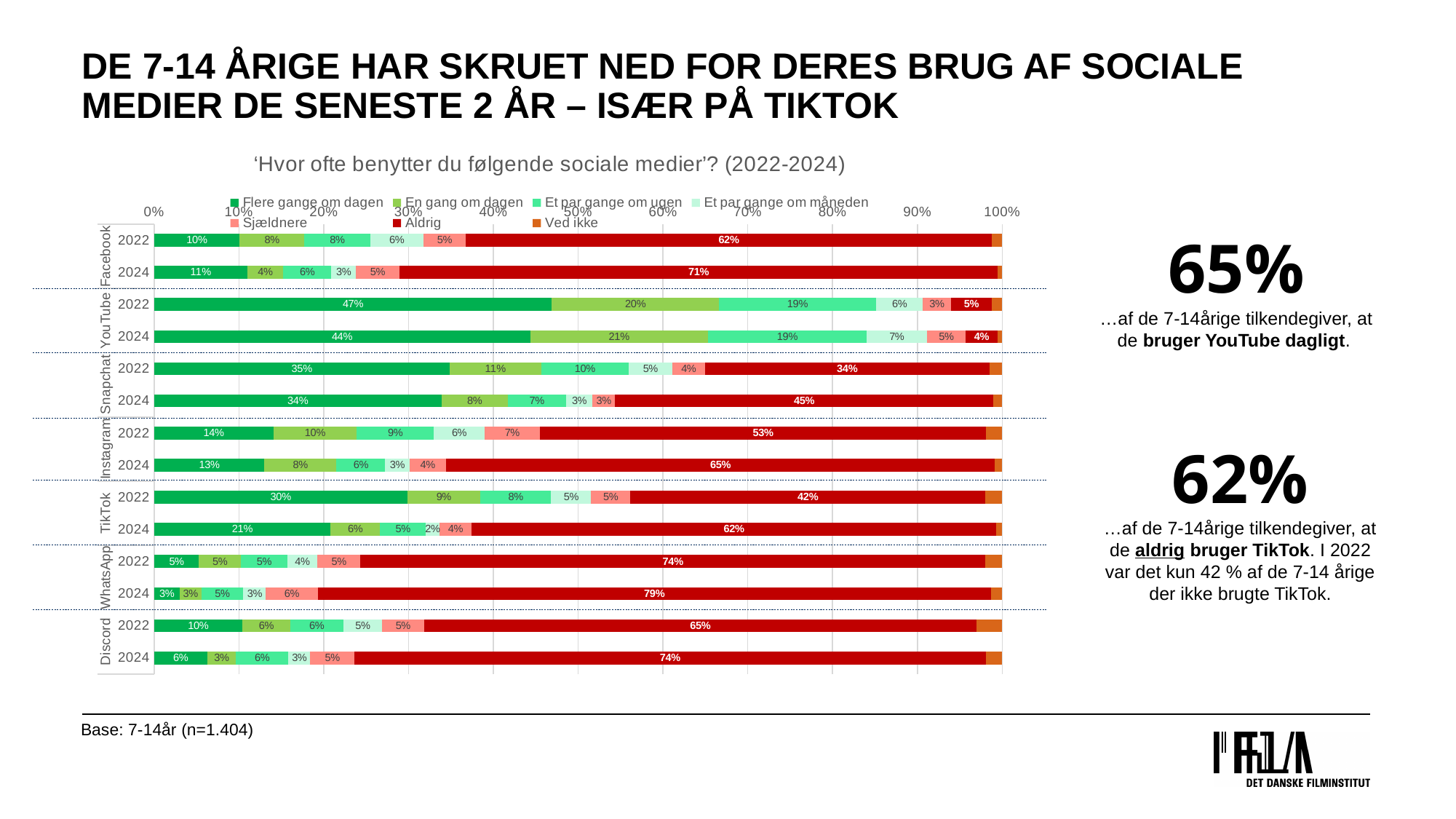
What kind of chart is shown on the slide? Stacked bar chart Which platform has the lowest 'Aldrig' value in 2022? YouTube Is the 'Aldrig' value for Instagram in 2024 larger or smaller than the 'Aldrig' value for Instagram in 2022? Larger What is the 'Aldrig' value for WhatsApp in 2024? 79% What is the difference between the 'Aldrig' values for Facebook in 2024 and 2022? 9 percentage points What is the 'Flere gange om dagen' value for YouTube in 2022? 47% How many series does the legend list? 7 What is the 'Aldrig' value for TikTok in 2024? 62% Which platform has the highest 'Flere gange om dagen' value in 2024? YouTube By how many percentage points did the 'Aldrig' value for TikTok change from 2022 to 2024? 20 percentage points What is the title of the chart? 'Hvor ofte benytter du følgende sociale medier'? (2022-2024) What is the 'En gang om dagen' value for Snapchat in 2024? 8%